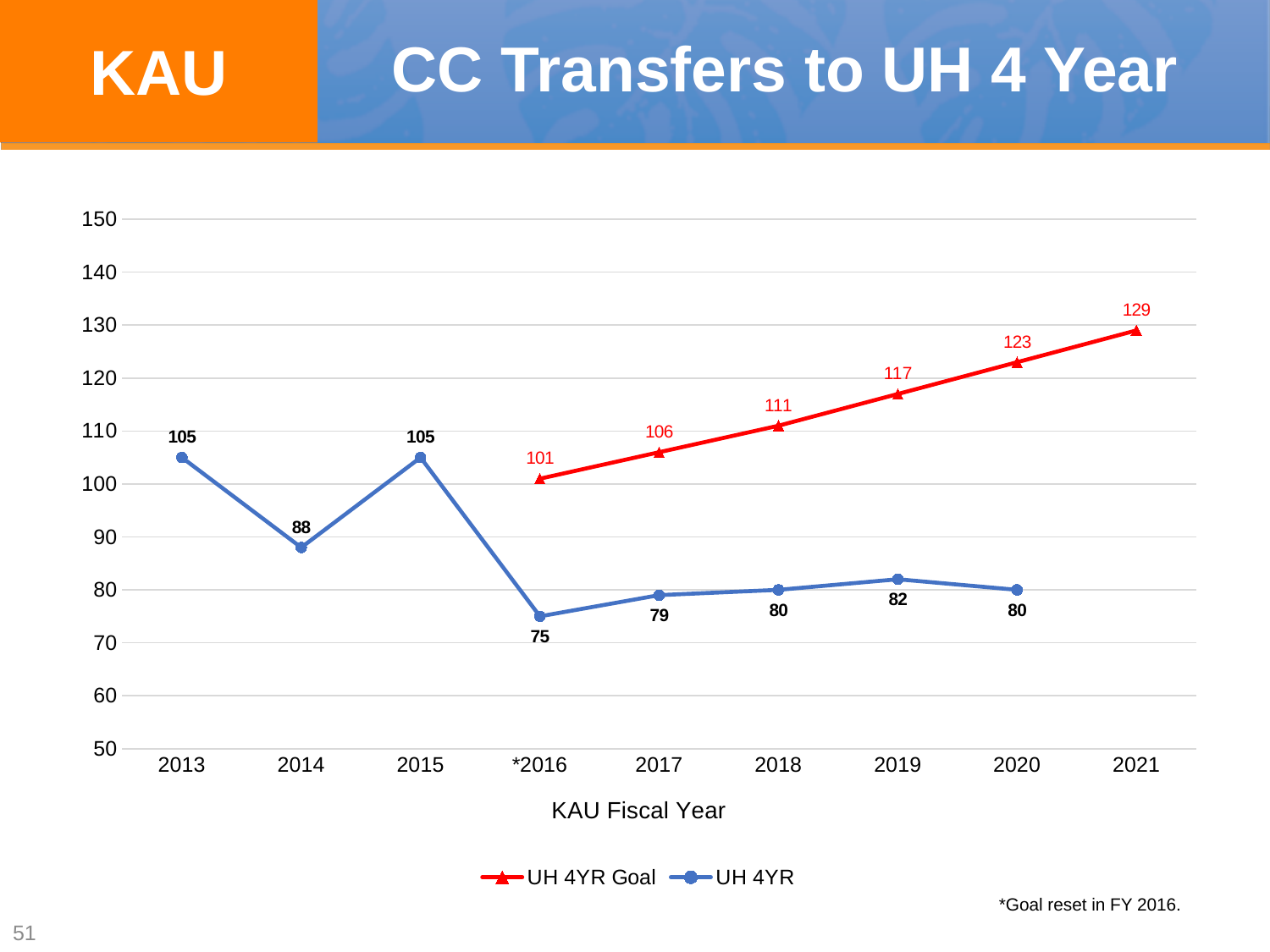
Which year has the lowest UH 4YR value? *2016 What is the UH 4YR value for 2014? 88 What is the x-axis title of the chart? KAU Fiscal Year Does the UH 4YR Goal series rise or fall from *2016 to 2021? Rise What is the difference between the UH 4YR Goal and the UH 4YR value in 2020? 43 What is the UH 4YR value for *2016? 75 How many years are shown on the x axis? 9 What kind of chart is shown on the slide? Line chart How many series does the legend list? 2 What is the UH 4YR Goal value for 2021? 129 Which is larger in 2019, the UH 4YR Goal or the UH 4YR value? UH 4YR Goal Which year has the highest UH 4YR Goal value? 2021